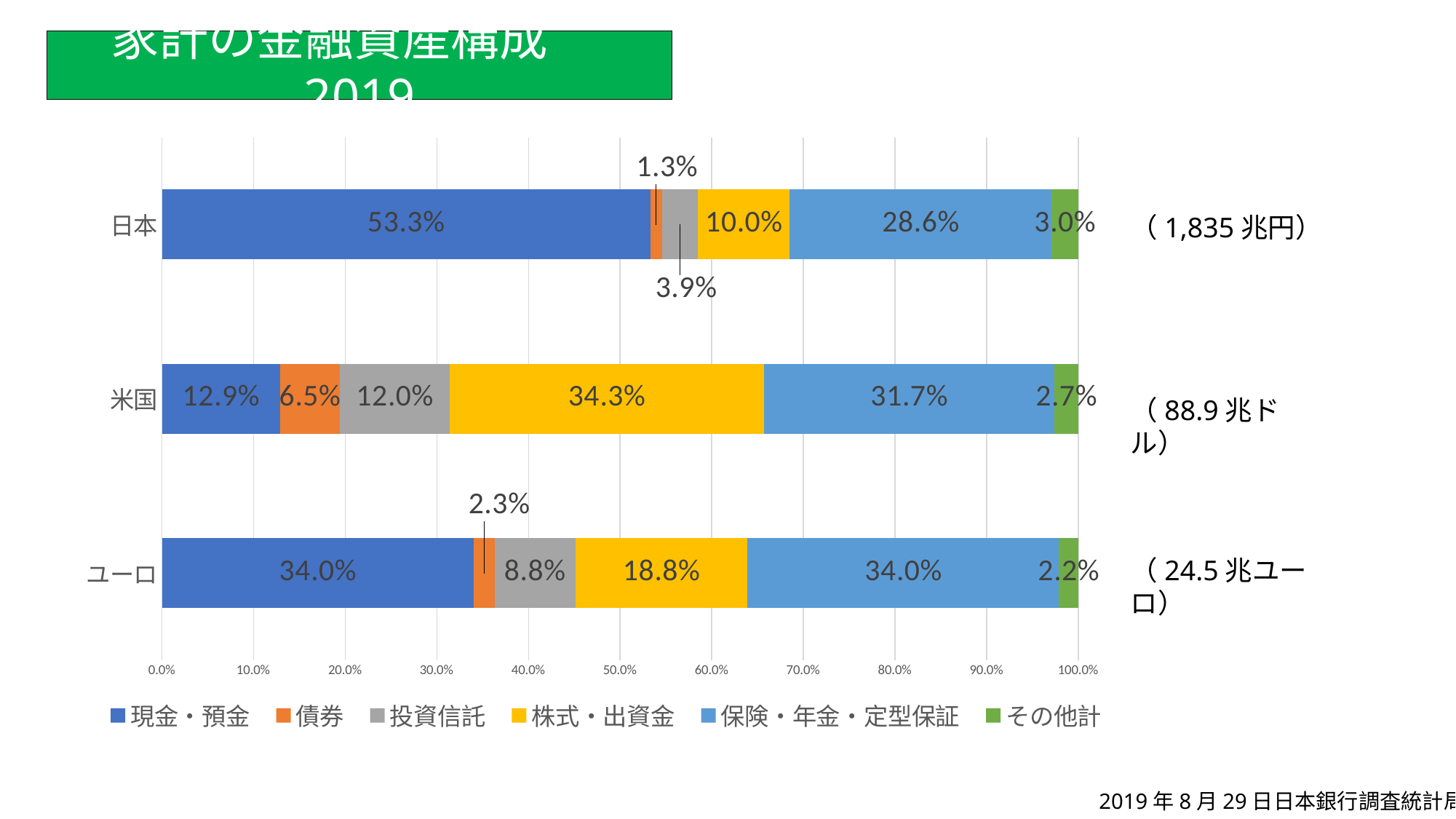
Which region has the highest value for 現金・預金? 日本 What is the value of 債券 for ユーロ? 2.3% What is the value of 投資信託 for 日本? 3.9% Which is larger: 投資信託 for 米国 or 投資信託 for ユーロ? 米国 What is the value of 株式・出資金 for 米国? 34.3% What is the total amount shown next to the 日本 bar? 1,835 兆円 How many categories (regions) are plotted on the chart? 3 How many series does the legend list? 6 What type of chart is shown on the slide? Stacked bar chart Which region has the lowest value for 株式・出資金? 日本 What is the difference between the 保険・年金・定型保証 values for 米国 and 日本? 3.1% What is the value of 現金・預金 for 日本? 53.3%